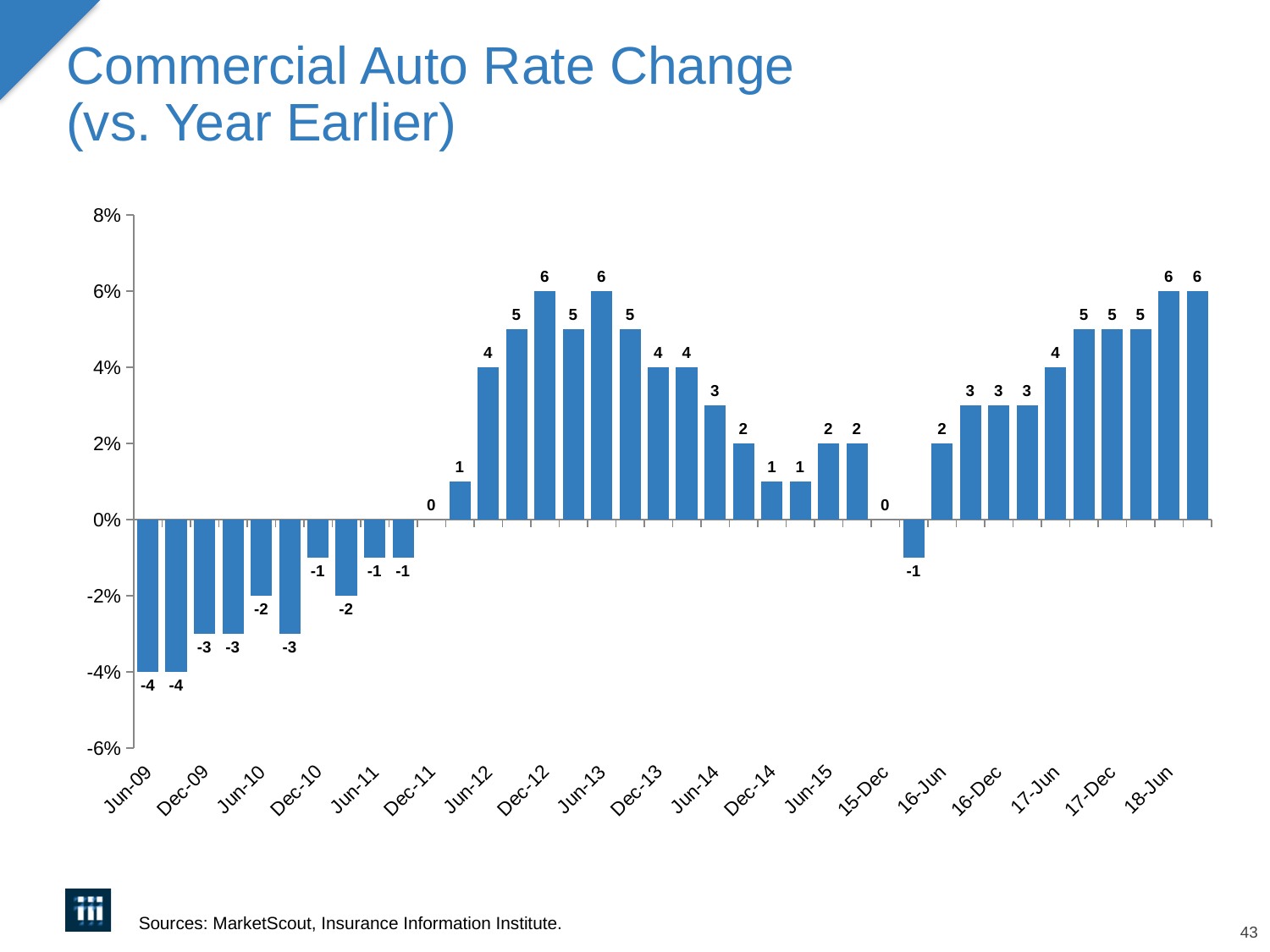
Which has the larger rate change, Jun-12 or Jun-14? Jun-12 What is the commercial auto rate change for Jun-09? -4 What is the commercial auto rate change for 17-Dec? 5 What is the difference between the rate change for 18-Jun and the rate change for Jun-09? 10 What is the lowest rate change value labeled on the chart? -4 What is the commercial auto rate change for Jun-14? 3 What is the commercial auto rate change for 15-Dec? 0 What is the commercial auto rate change for Dec-12? 6 Do the values generally rise or fall from Jun-09 to Dec-12? Rise What kind of chart is shown on the slide? Bar chart What is the highest rate change value labeled on the chart? 6 How many bars are plotted on the chart? 38